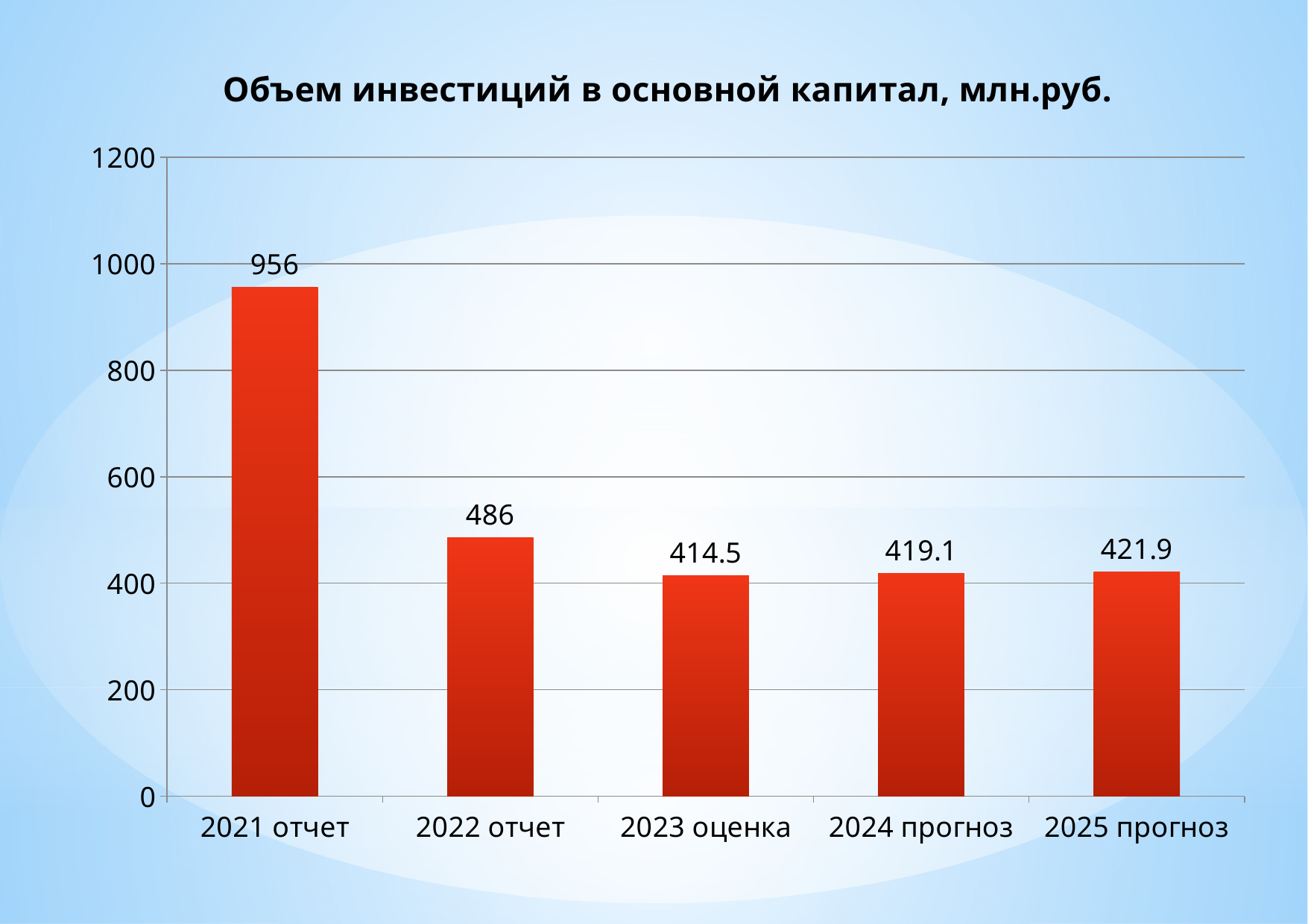
What is the value for 2023 оценка? 414.5 Which category has the lowest value? 2023 оценка Which is larger, the value for 2022 отчет or the value for 2024 прогноз? 2022 отчет What is the value for 2021 отчет? 956 What is the title of the chart? Объем инвестиций в основной капитал, млн.руб. How many categories are shown on the x axis? 5 What kind of chart is shown on the slide? bar chart What is the difference between the values for 2021 отчет and 2022 отчет? 470 What is the difference between the values for 2025 прогноз and 2024 прогноз? 2.8 What is the value for 2025 прогноз? 421.9 Is the value for 2022 отчет greater or less than 400? greater Which category has the highest value? 2021 отчет